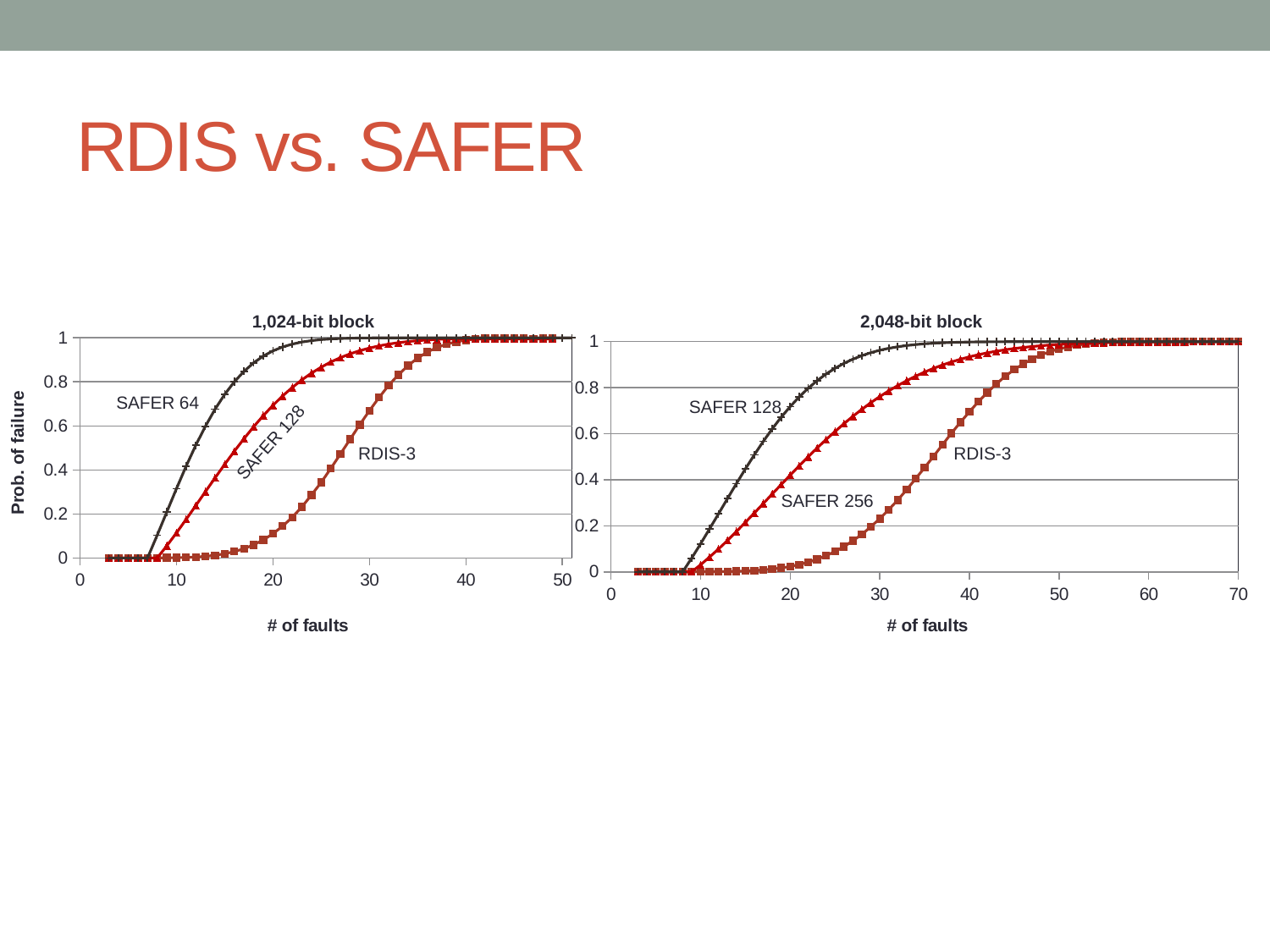
What is the maximum value shown on the x axis of the 2,048-bit block chart? 70 In the 2,048-bit block chart, is the value for SAFER 128 at 20 faults greater or less than 0.6? greater What is the label of the x axis in the 2,048-bit block chart? # of faults In the 1,024-bit block chart, at 20 faults, which has the higher probability of failure: SAFER 64 or RDIS-3? SAFER 64 In the 1,024-bit block chart, which three series are labelled? SAFER 64, SAFER 128, RDIS-3 In the 2,048-bit block chart, do the values of RDIS-3 rise or fall as the number of faults increases? rise In the 1,024-bit block chart, is the value for RDIS-3 at 20 faults greater or less than 0.2? less What kind of chart is the 1,024-bit block chart? line chart In the 2,048-bit block chart, is the value for RDIS-3 at 40 faults greater or less than 0.4? greater How many series are plotted in the 2,048-bit block chart? 3 In the 2,048-bit block chart, at 30 faults, which has the higher probability of failure: SAFER 128 or RDIS-3? SAFER 128